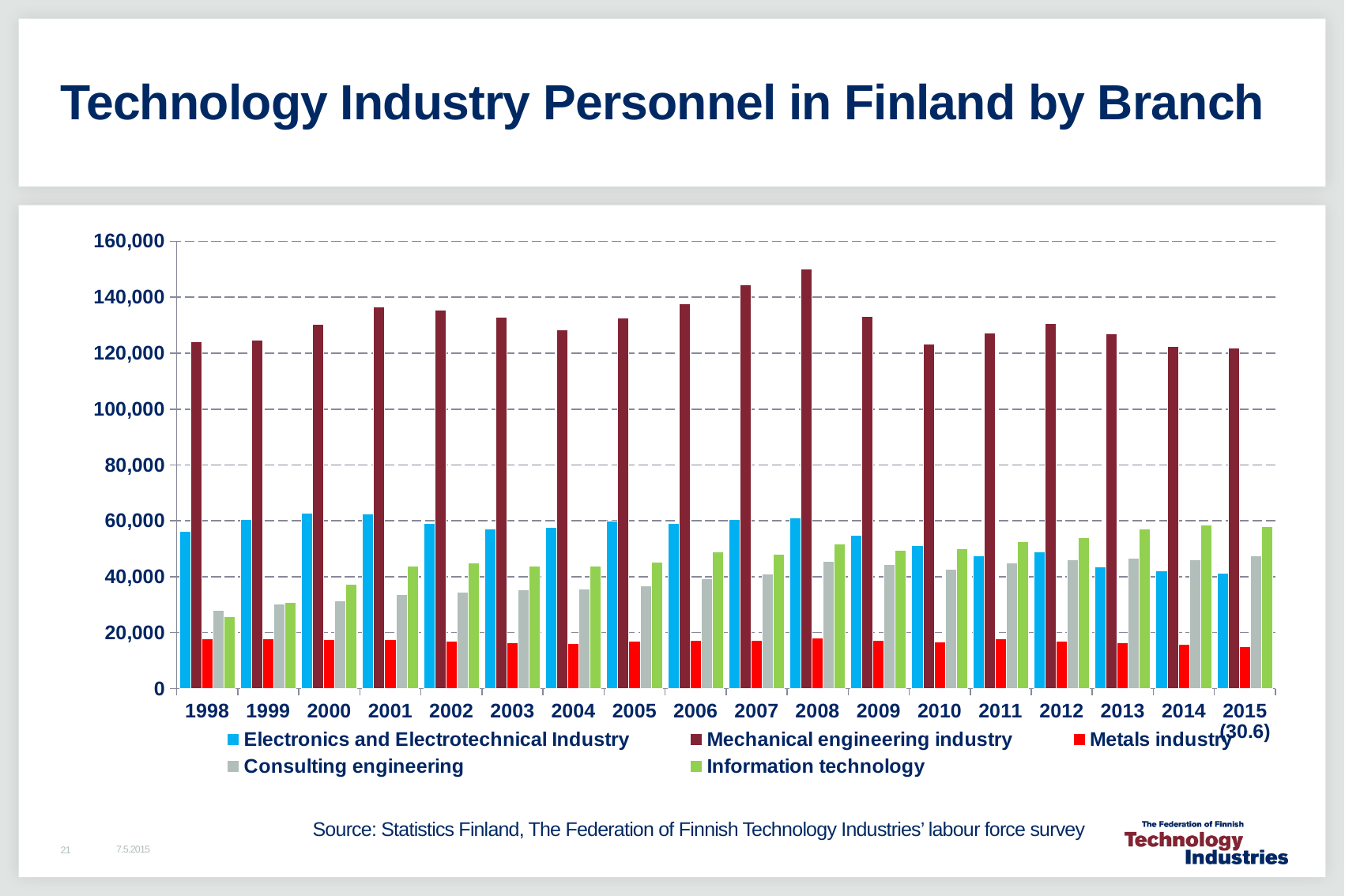
How many years are shown on the x axis? 18 Is the value for Mechanical engineering industry in 2008 greater or less than 140,000? greater In which year is the Information technology bar lowest? 1998 Is the value for Electronics and Electrotechnical Industry in 1998 greater or less than 60,000? less How many series does the legend list? 5 In which year is the Mechanical engineering industry bar highest? 2008 Is the value for Metals industry in 2015 (30.6) greater or less than 20,000? less Does the Information technology series generally rise or fall from 1998 to 2015? rise Which is larger in 2015 (30.6): Electronics and Electrotechnical Industry or Information technology? Information technology What kind of chart is shown on the slide? bar chart What colour represents the Metals industry in the chart? red In which year is the Consulting engineering bar lowest? 1998